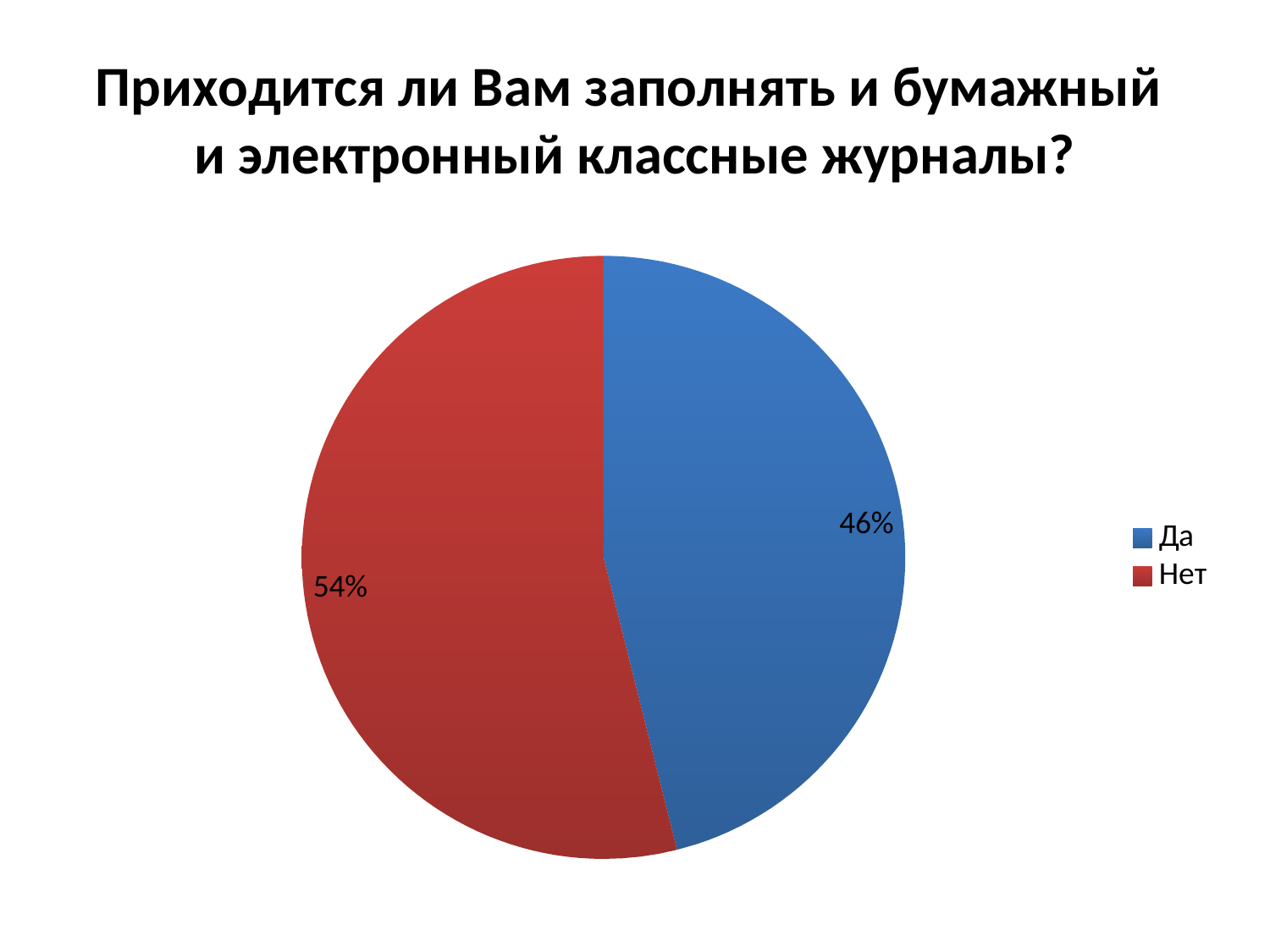
Which slice is the smallest in the pie chart? Да What share of the pie does the "Да" slice represent? 46% What share of the pie does the "Нет" slice represent? 54% How many slices does the pie chart have? 2 What is the difference in percentage points between the "Нет" and "Да" slices? 8 What kind of chart is shown on the slide? Pie chart What colour is the "Нет" slice? Red What is the total of the two slices shown in the pie chart? 100% How many entries does the legend list? 2 Which slice is the largest in the pie chart? Нет Which is larger, the "Да" slice or the "Нет" slice? Нет What is the title of the slide? Приходится ли Вам заполнять и бумажный и электронный классные журналы?